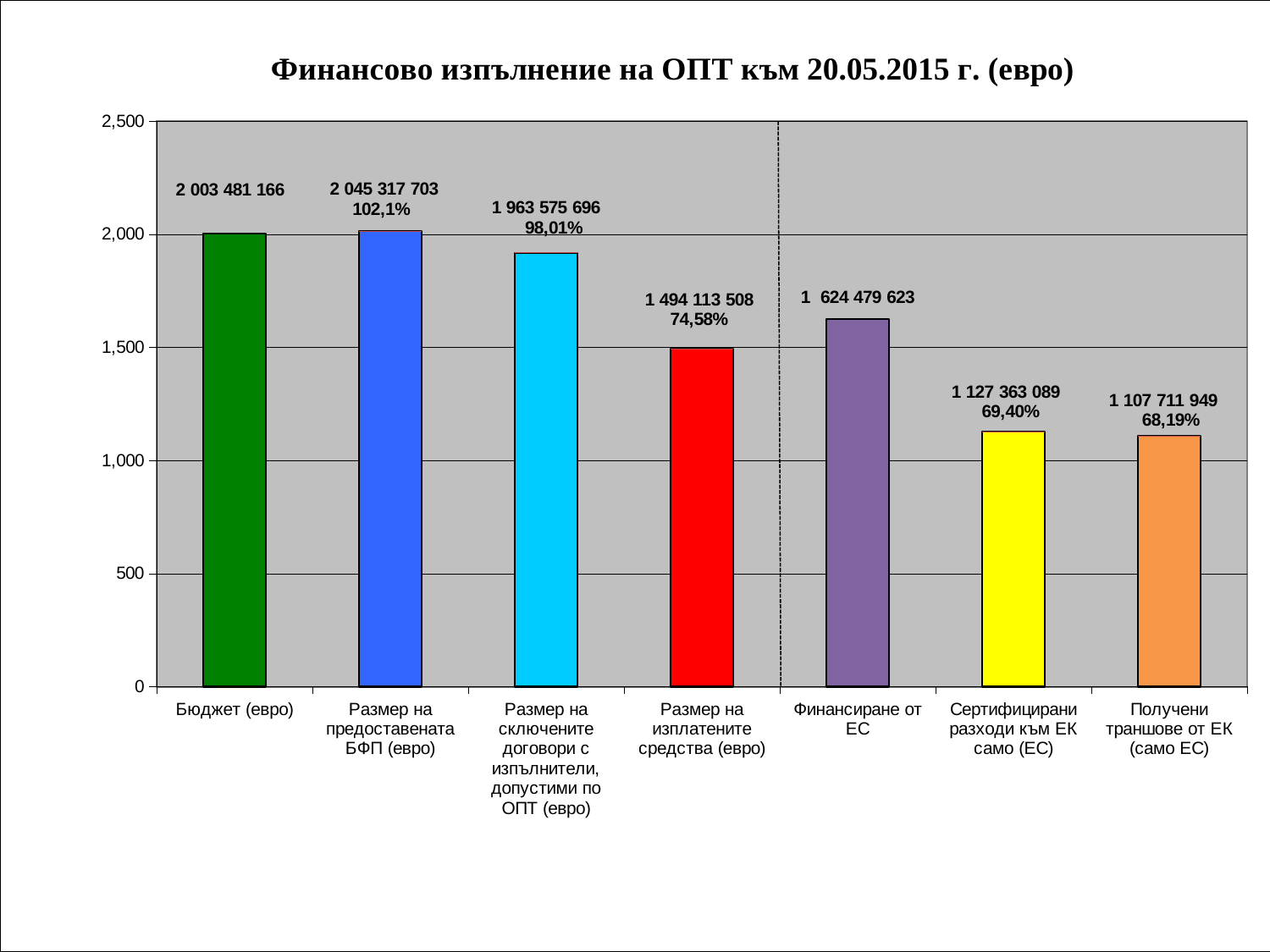
What is the value shown for Бюджет (евро)? 2 003 481 166 Is the bar for Финансиране от ЕС greater or less than 1,500 on the axis? greater What is the difference between Размер на предоставената БФП (евро) and Бюджет (евро)? 41 836 537 What type of chart is shown on the slide? bar chart What is the difference between Сертифицирани разходи към ЕК само (ЕС) and Получени траншове от ЕК (само ЕС)? 19 651 140 Which is larger: Размер на сключените договори с изпълнители, допустими по ОПТ (евро) or Размер на изплатените средства (евро)? Размер на сключените договори с изпълнители, допустими по ОПТ (евро) How many bars are plotted on the chart? 7 What is the value shown for Финансиране от ЕС? 1 624 479 623 What percentage is shown for Сертифицирани разходи към ЕК само (ЕС)? 69,40% Which category has the highest bar? Размер на предоставената БФП (евро) What is the value shown for Размер на предоставената БФП (евро)? 2 045 317 703 What percentage is shown above the bar for Размер на изплатените средства (евро)? 74,58%